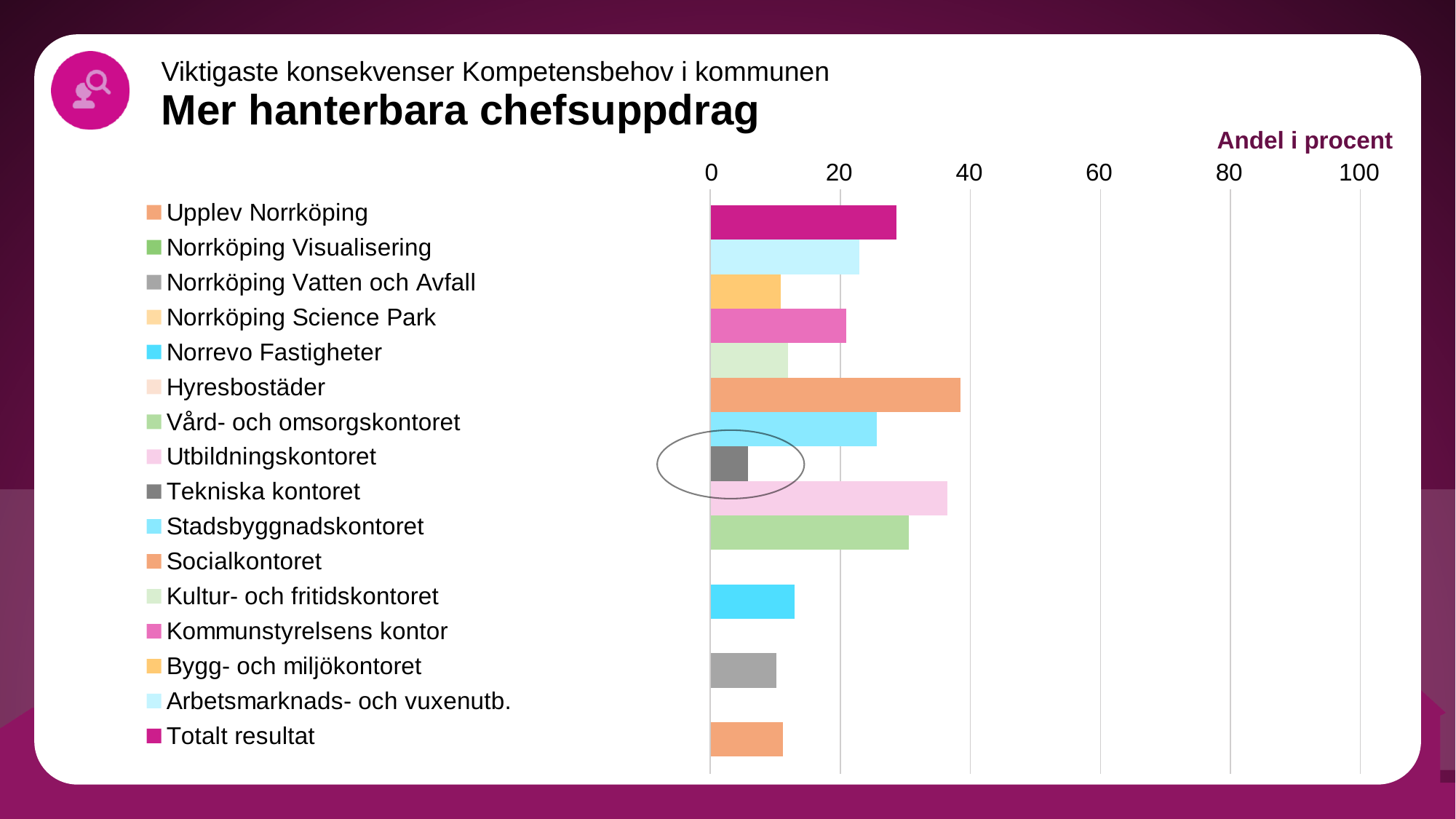
What kind of chart is shown on the slide? bar chart Is the value for Utbildningskontoret greater or less than 60? less Is the value for Norrevo Fastigheter greater or less than 20? less Which is larger, the value for Vård- och omsorgskontoret or the value for Kommunstyrelsens kontor? Vård- och omsorgskontoret Is the value for Socialkontoret greater or less than 20? greater Which legend entry corresponds to the bar that is circled on the chart? Tekniska kontoret How many entries does the chart legend list? 16 Which is larger, the value for Utbildningskontoret or the value for Norrevo Fastigheter? Utbildningskontoret Which is larger, the value for Socialkontoret or the value for Tekniska kontoret? Socialkontoret What is the axis title shown above the chart's value axis? Andel i procent